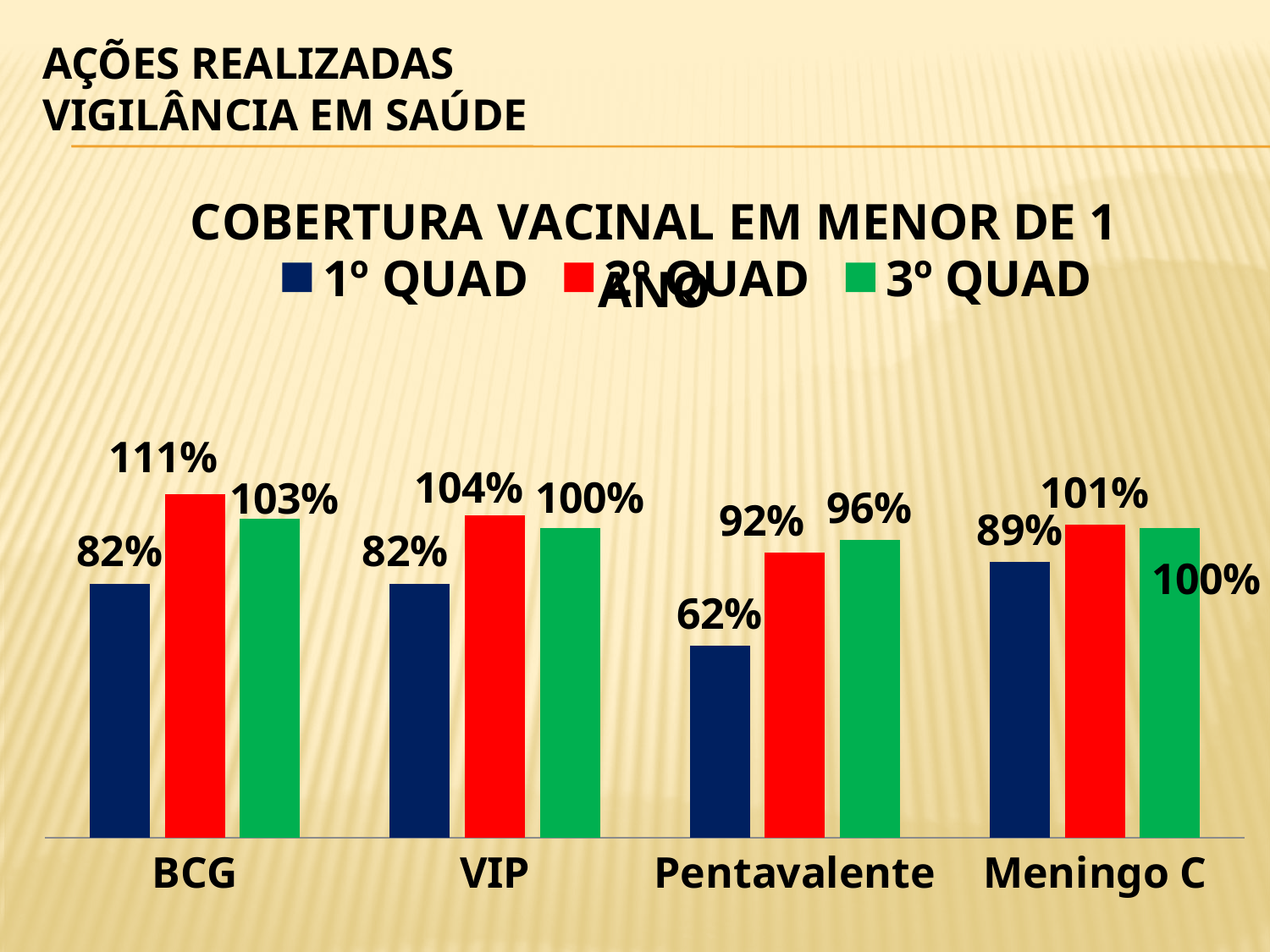
Which is larger for BCG: the 2º QUAD value or the 3º QUAD value? 2º QUAD What is the value for BCG in the 2º QUAD series? 111% Which category has the highest value in the 2º QUAD series? BCG What kind of chart is shown on the slide? Bar chart What colour represents the 3º QUAD series in the legend? Green What is the value for VIP in the 2º QUAD series? 104% How many categories are shown on the x axis? 4 What is the value for Pentavalente in the 1º QUAD series? 62% Which category has the lowest value in the 1º QUAD series? Pentavalente What is the difference between the 2º QUAD and 1º QUAD values for Pentavalente? 30% How many series does the legend list? 3 What is the value for Meningo C in the 3º QUAD series? 100%